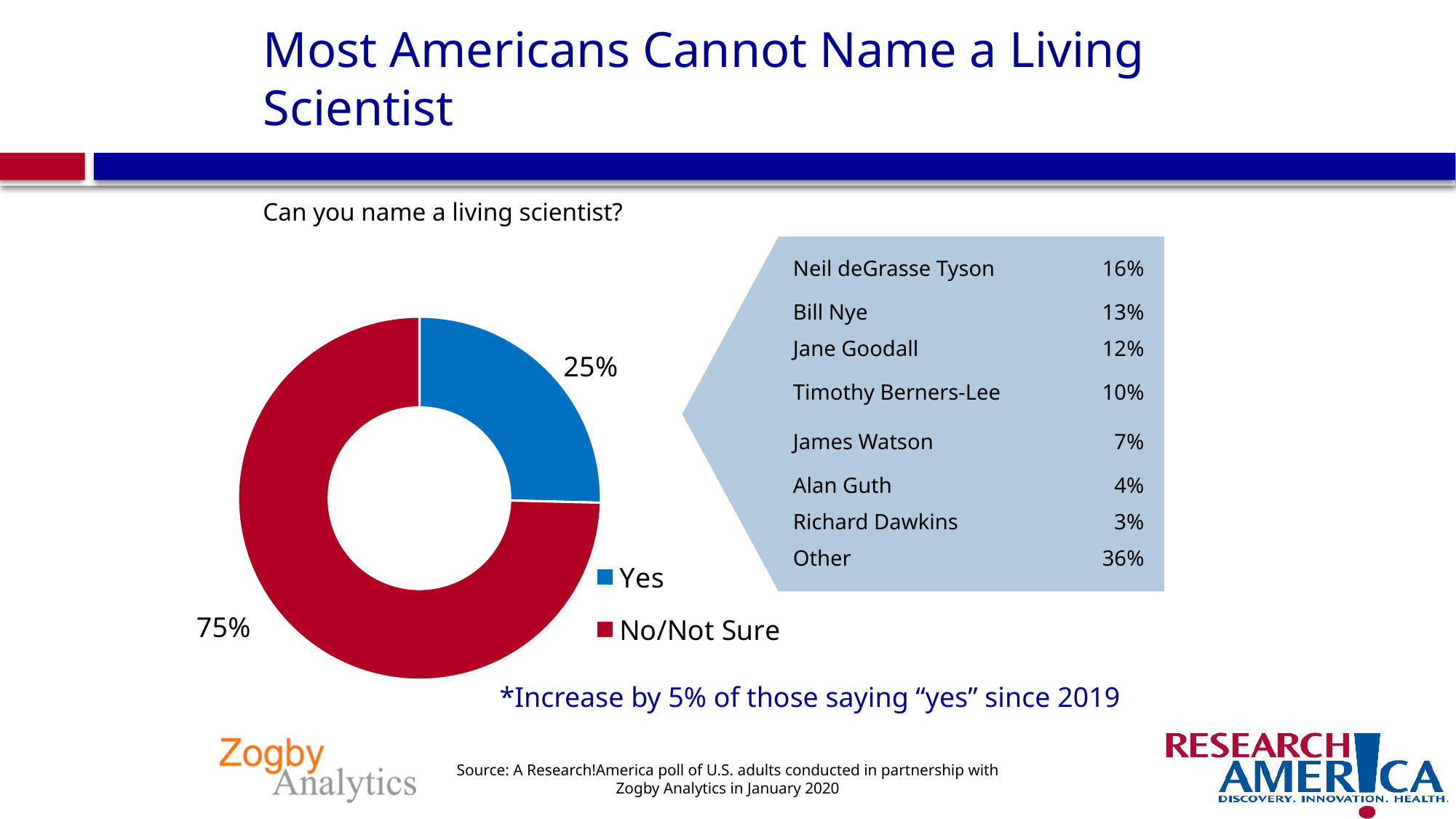
Is the share for Yes larger or smaller than the share for No/Not Sure? smaller What is the difference in percentage points between the No/Not Sure share and the Yes share? 50 What colour is the No/Not Sure slice of the donut chart? red Which response has the larger share of the donut chart? No/Not Sure How many categories does the donut chart show? 2 What share of the donut chart does the Yes slice represent? 25% What question is the donut chart answering, as written above it? Can you name a living scientist? What percentage of respondents answered No/Not Sure? 75% Which response has the smaller share of the donut chart? Yes How many entries does the chart legend list? 2 What percentage of respondents said Yes to being able to name a living scientist? 25% What type of chart is used to show the responses to 'Can you name a living scientist?' donut (pie) chart